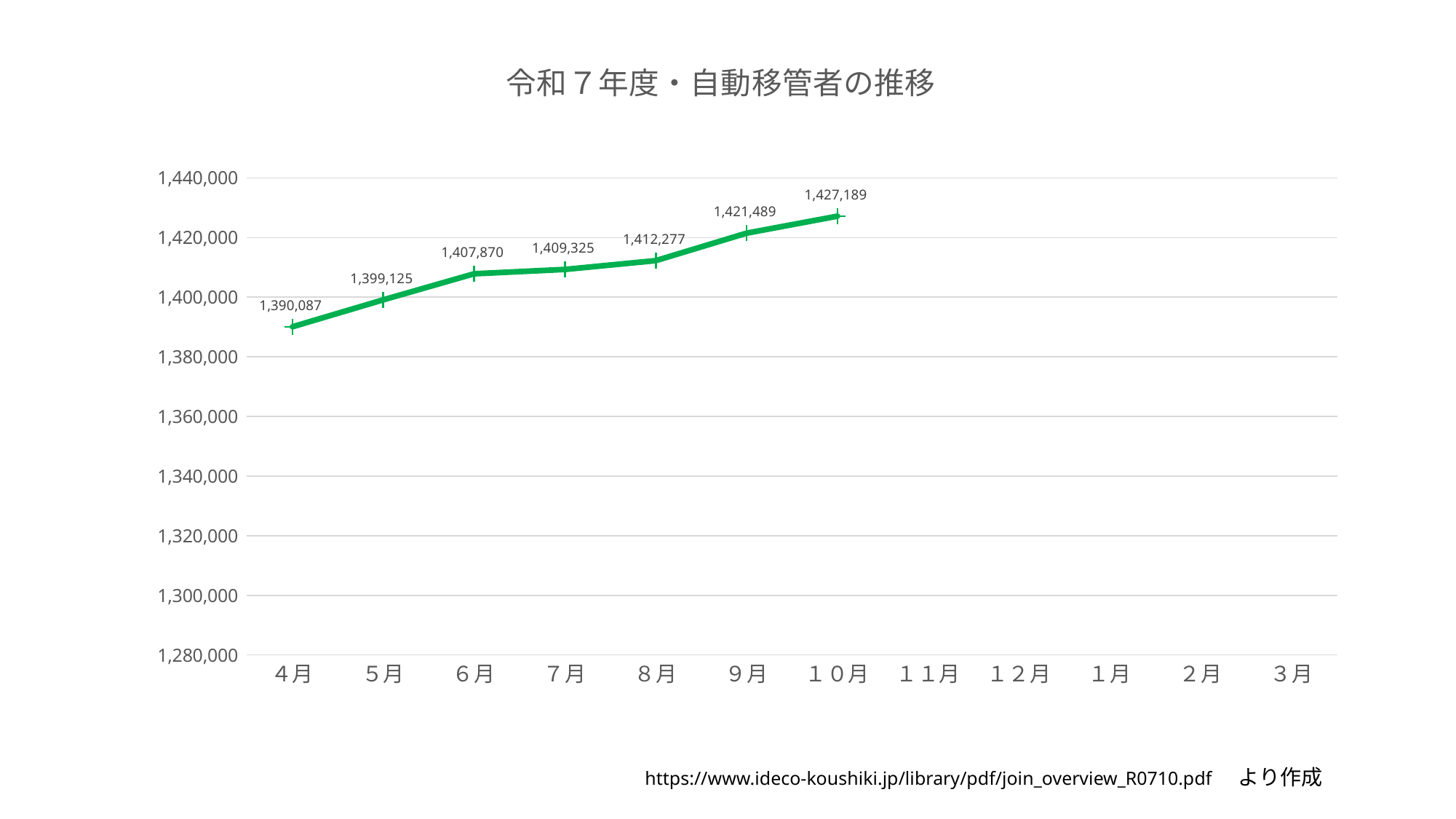
Do the values rise or fall from 4月 to 10月? rise What kind of chart is shown on the slide? line chart Which is larger, the value for 6月 or the value for 5月? 6月 What is the value for 10月? 1,427,189 Is the value for 8月 greater or less than 1,400,000? greater What is the difference between the values for 9月 and 8月? 9,212 What is the value for 7月? 1,409,325 Which month has the highest plotted value? 10月 How many data points are plotted on the line? 7 What is the difference between the values for 10月 and 4月? 37,102 What is the value for 4月? 1,390,087 Which month has the lowest plotted value? 4月